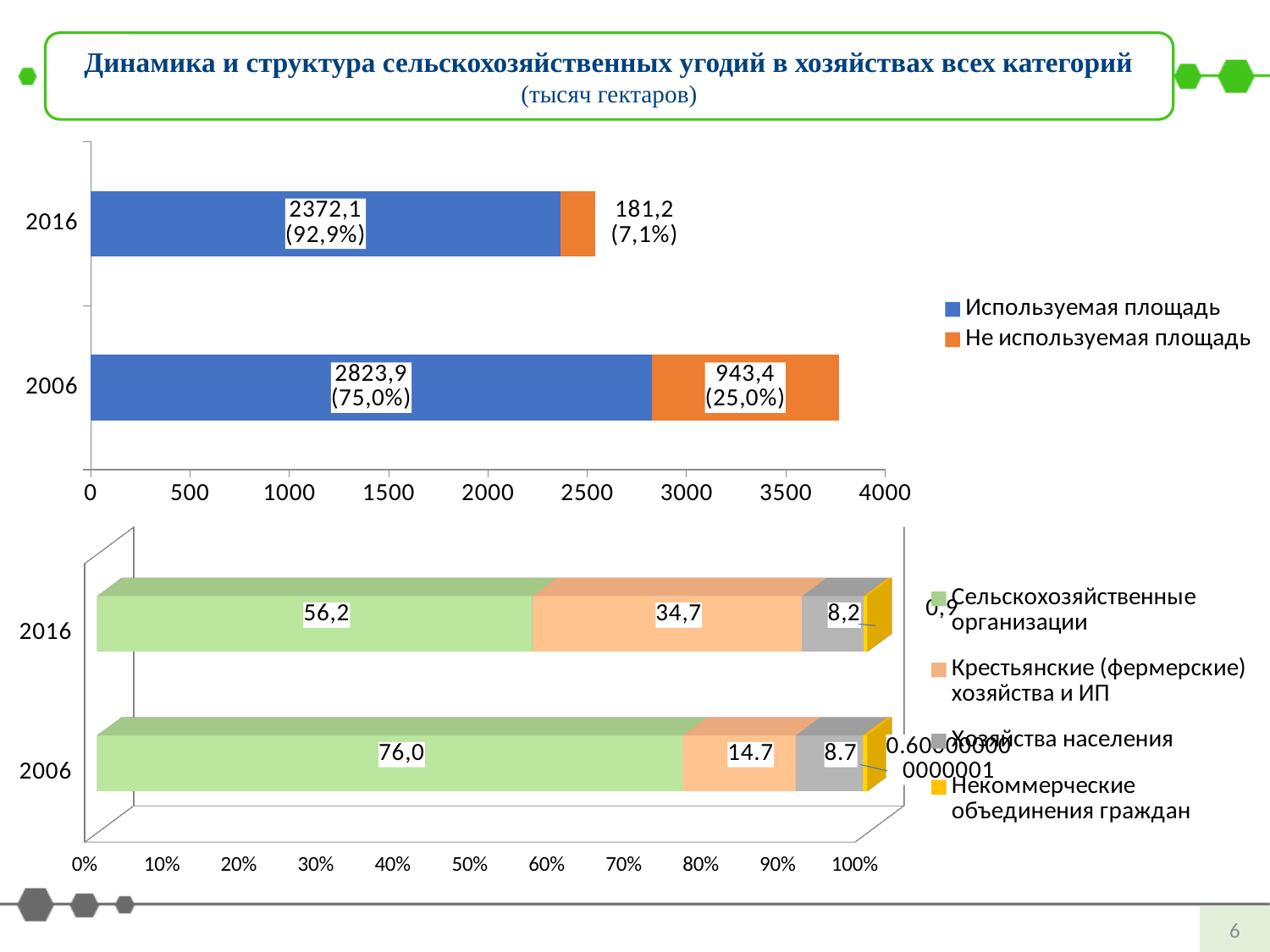
In the top chart, what is the value of Не используемая площадь for 2006? 943,4 In the bottom chart, which series has the largest share in 2016? Сельскохозяйственные организации In the top chart, what is the total of the stacked bar for 2006? 3767,3 In the top chart, what is the value of Используемая площадь for 2016? 2372,1 In the bottom chart, how many series does the legend list? 4 What type of chart is the top chart? Stacked bar chart In the top chart, what percentage share is shown for Не используемая площадь in 2016? 7,1% In the top chart, how many series does the legend list? 2 In the bottom chart, what is the value for Сельскохозяйственные организации in 2016? 56,2 In the top chart, which year has the larger value for Не используемая площадь, 2006 or 2016? 2006 In the bottom chart, what is the value for Крестьянские (фермерские) хозяйства и ИП in 2006? 14.7 In the top chart, what is the difference between Используемая площадь in 2006 and in 2016? 451,8